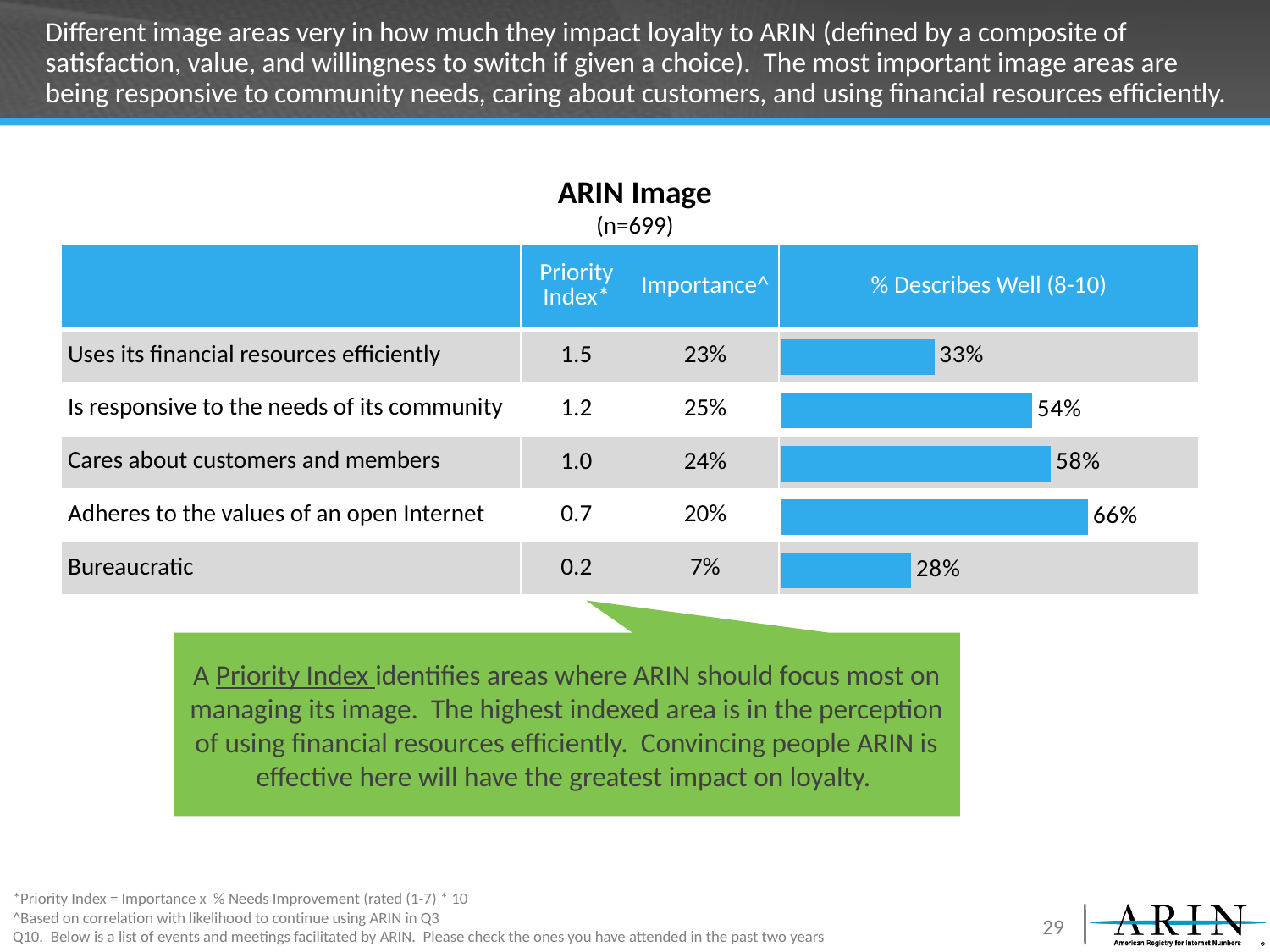
What is the % Describes Well value for 'Adheres to the values of an open Internet'? 66% What kind of chart is used to show the % Describes Well values? Bar chart What is the difference in % Describes Well between 'Cares about customers and members' and 'Is responsive to the needs of its community'? 4% Which image area has the lowest % Describes Well value? Bureaucratic Which has a higher % Describes Well value: 'Uses its financial resources efficiently' or 'Is responsive to the needs of its community'? Is responsive to the needs of its community What is the % Describes Well value for 'Uses its financial resources efficiently'? 33% What is the % Describes Well value for 'Bureaucratic'? 28% What is the sample size (n) shown under the chart title? 699 How many image areas are shown in the % Describes Well bar chart? 5 What is the title of the chart? ARIN Image What is the difference in % Describes Well between 'Adheres to the values of an open Internet' and 'Bureaucratic'? 38% Which image area has the highest % Describes Well value? Adheres to the values of an open Internet